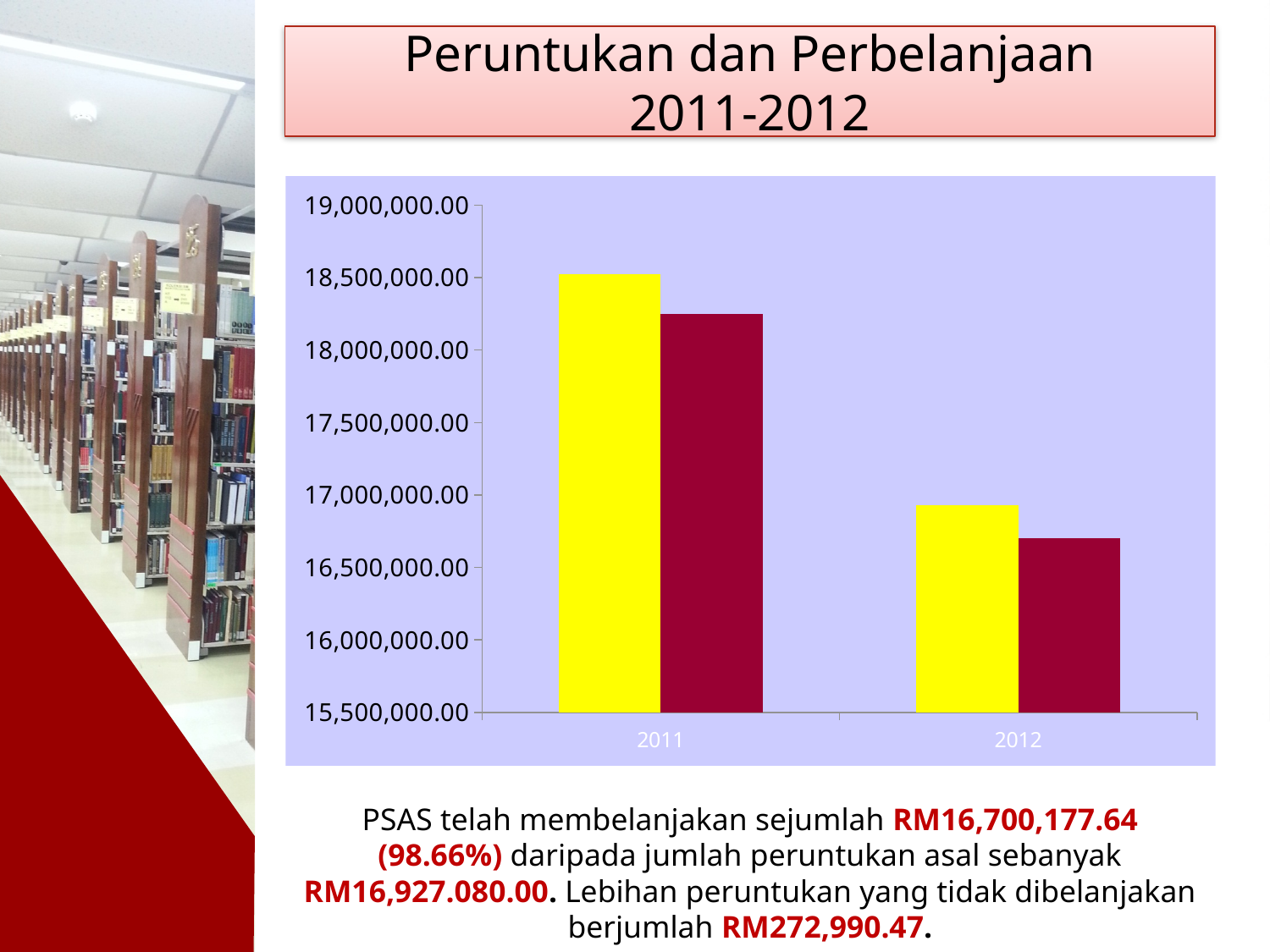
Which years are shown as categories on the x axis? 2011 and 2012 Within 2012, which bar is taller, the yellow bar or the dark red bar? the yellow bar Is the value of the yellow bar for 2012 greater or less than 17,000,000.00? less Is the value of the yellow bar for 2011 greater or less than 18,000,000.00? greater Is the value of the dark red bar for 2011 greater or less than 18,000,000.00? greater What is the title of the slide containing the chart? Peruntukan dan Perbelanjaan 2011-2012 Which year has the higher yellow bar, 2011 or 2012? 2011 Do the values rise or fall from 2011 to 2012? fall How many categories are shown on the x axis of the chart? 2 What kind of chart is shown on the slide? bar chart